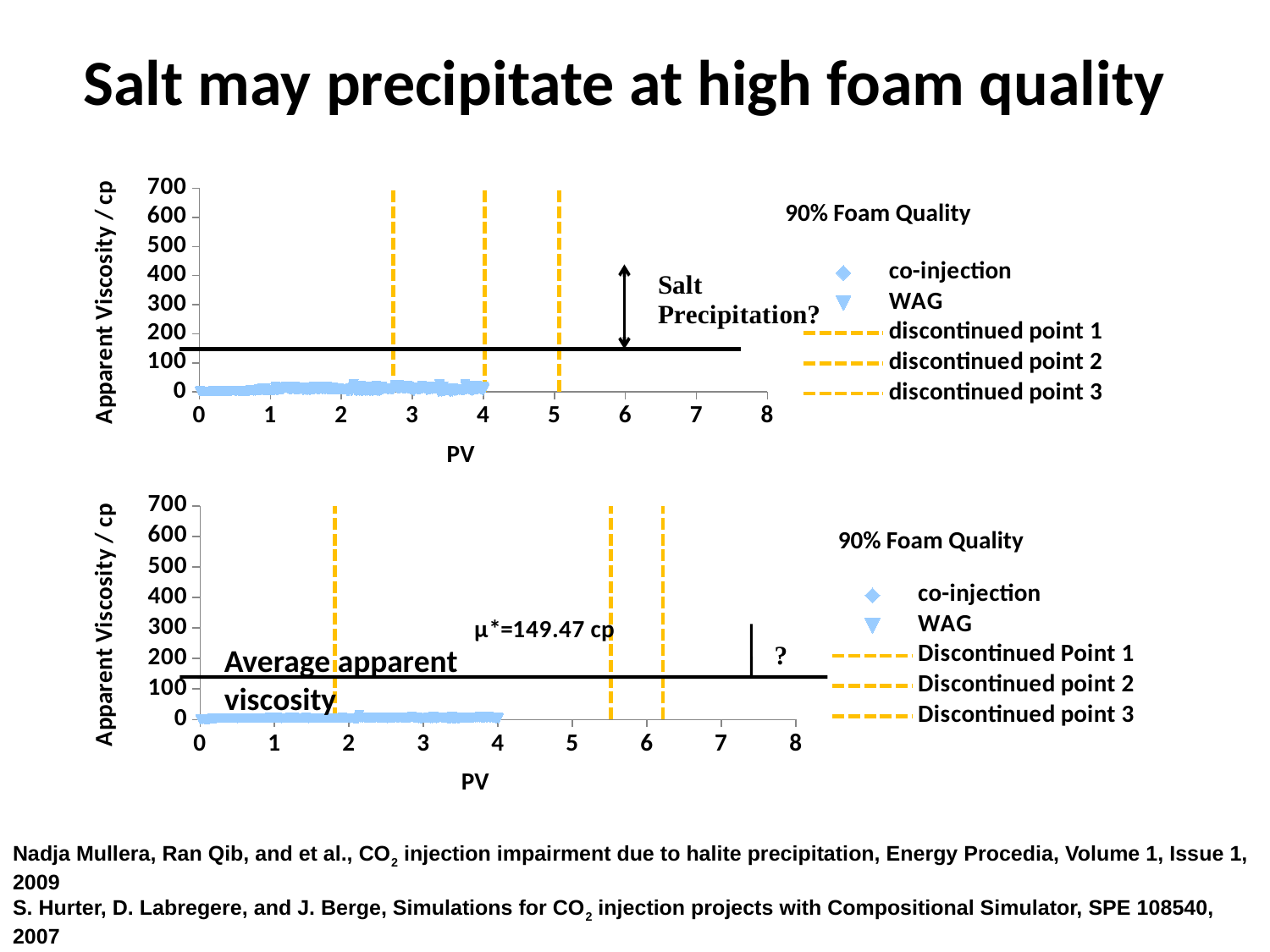
What is the label of the x axis on the bottom chart? PV What is the highest tick value shown on the x axis of the bottom chart? 8 How many series does the legend of the bottom chart list? 5 In the bottom chart, what is the average apparent viscosity μ* printed on the chart? 149.47 cp What kind of chart is the top chart on the slide? scatter chart What is the label of the y axis on the top chart? Apparent Viscosity / cp How many series does the legend of the top chart list? 5 In the top chart, how many discontinued points are listed in the legend? 3 What is the highest tick value shown on the y axis of the top chart? 700